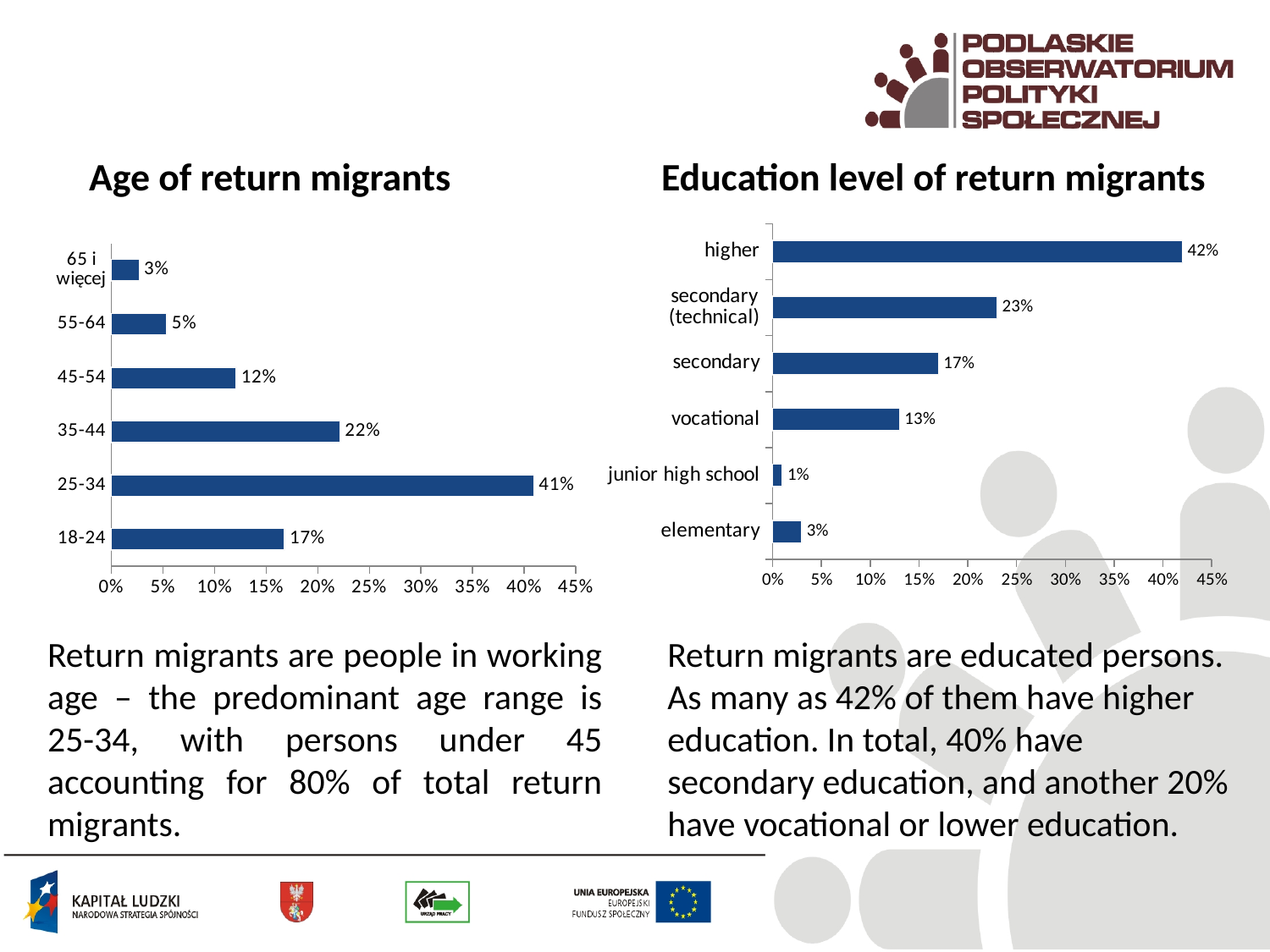
In the 'Education level of return migrants' chart, what is the difference between higher and secondary (technical)? 19% What type of chart is the 'Education level of return migrants' chart? bar chart In the 'Education level of return migrants' chart, which is larger: secondary (technical) or secondary? secondary (technical) In the 'Age of return migrants' chart, what is the value for the 25-34 age group? 41% In the 'Education level of return migrants' chart, which category has the lowest value? junior high school In the 'Age of return migrants' chart, what is the value for the 45-54 age group? 12% In the 'Age of return migrants' chart, what is the difference between the 35-44 and 18-24 values? 5% In the 'Education level of return migrants' chart, what is the value for vocational? 13% In the 'Education level of return migrants' chart, which category has the highest value? higher In the 'Age of return migrants' chart, how many age categories are shown? 6 In the 'Age of return migrants' chart, which age group has the lowest value? 65 i więcej In the 'Education level of return migrants' chart, how many education categories are shown? 6